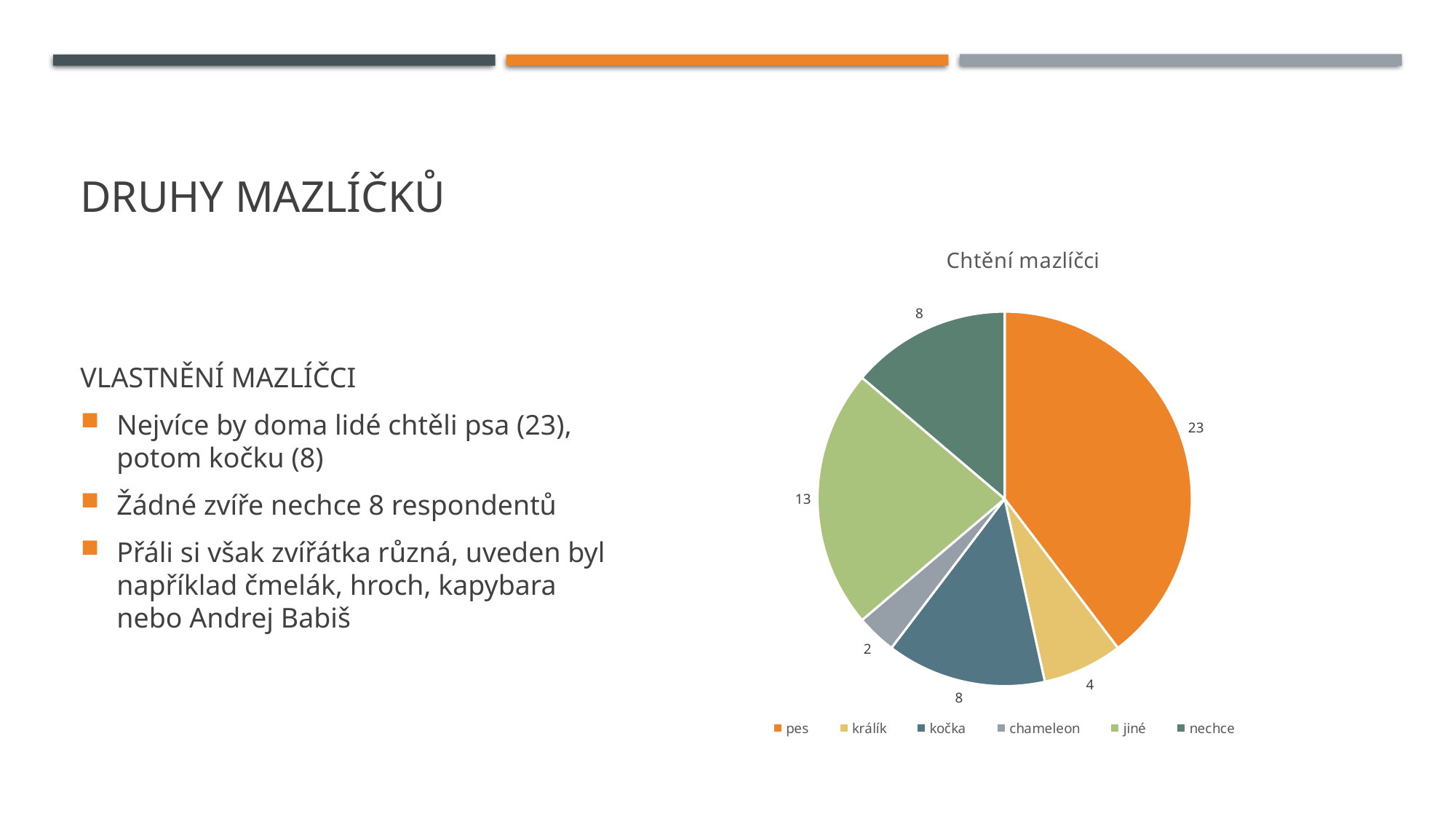
Which category has the smallest slice in the pie chart? chameleon Which category has the largest slice in the pie chart? pes What is the difference between the values for pes and jiné? 10 What is the value for pes in the pie chart? 23 What is the value for králík in the pie chart? 4 What is the value for chameleon in the pie chart? 2 What type of chart is shown on the slide? pie chart Which is larger, the value for kočka or the value for králík? kočka What is the total of all slices in the pie chart? 58 What is the value for jiné in the pie chart? 13 How many categories does the legend of the pie chart list? 6 What is the title of the chart? Chtění mazlíčci